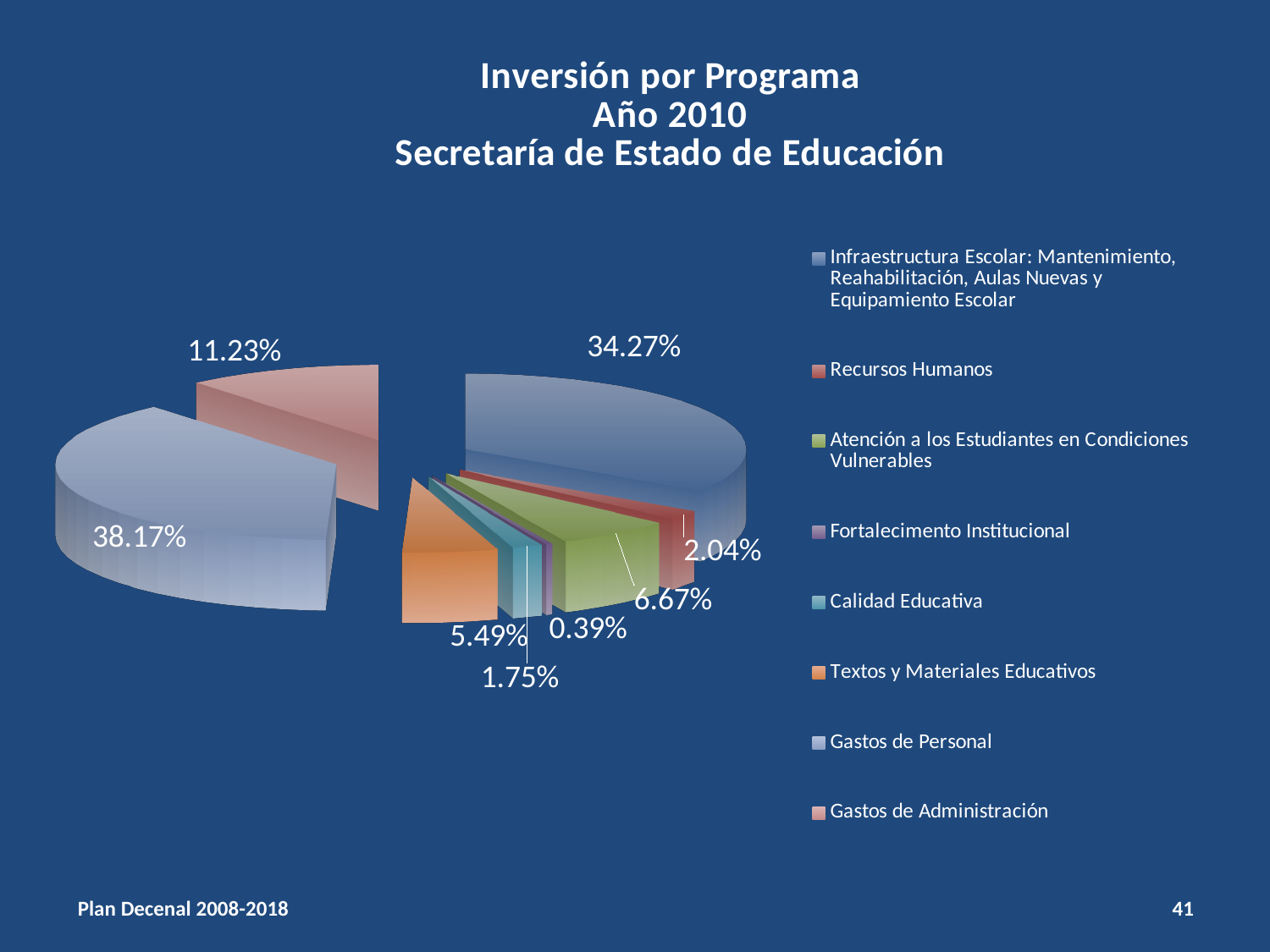
Which is larger, the share for Calidad Educativa or the share for Recursos Humanos? Recursos Humanos Which program has the smallest share of the investment? Fortalecimento Institucional What percentage is shown for Textos y Materiales Educativos? 5.49% Which program has the largest share of the investment? Gastos de Personal What share of the investment goes to Gastos de Personal? 38.17% What is the difference between the shares for Gastos de Personal and Infraestructura Escolar? 3.90% What percentage is shown for Recursos Humanos? 2.04% What share of the investment goes to Infraestructura Escolar: Mantenimiento, Reahabilitación, Aulas Nuevas y Equipamiento Escolar? 34.27% What kind of chart is shown on the slide? pie chart How many slices does the pie chart have? 8 What percentage is shown for Gastos de Administración? 11.23% What percentage is shown for Atención a los Estudiantes en Condiciones Vulnerables? 6.67%